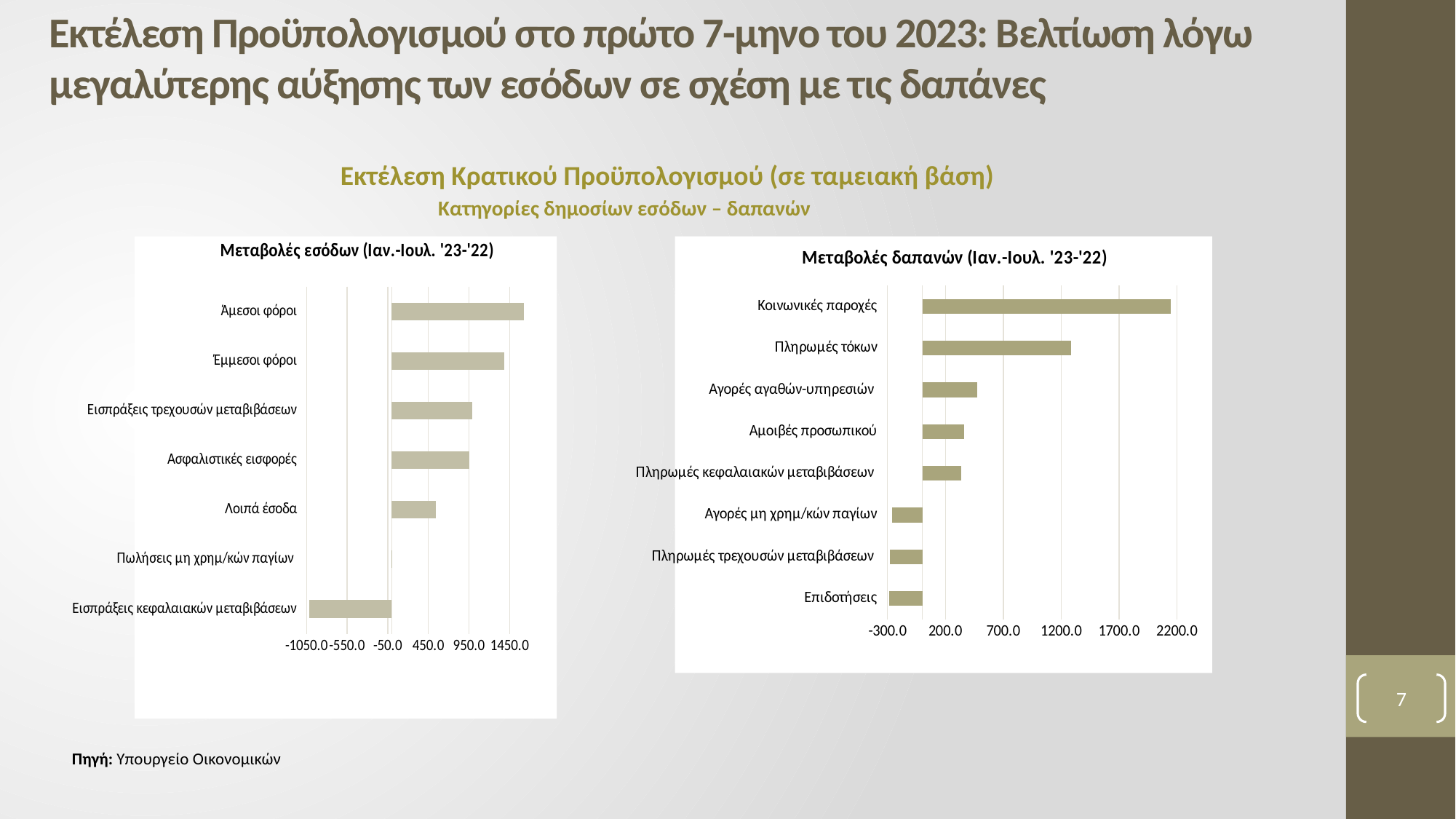
In the right chart 'Μεταβολές δαπανών', which is larger: Πληρωμές τόκων or Αγορές αγαθών-υπηρεσιών? Πληρωμές τόκων In the left chart 'Μεταβολές εσόδων', which category has the highest value? Άμεσοι φόροι In the right chart 'Μεταβολές δαπανών', which category has the highest value? Κοινωνικές παροχές In the right chart 'Μεταβολές δαπανών', is the value for Επιδοτήσεις greater or less than 200? less How many categories are shown in the right chart 'Μεταβολές δαπανών (Ιαν.-Ιουλ. '23-'22)'? 8 In the left chart 'Μεταβολές εσόδων', is the value for Άμεσοι φόροι greater or less than 1450? greater In the left chart 'Μεταβολές εσόδων', which category has the lowest value? Εισπράξεις κεφαλαιακών μεταβιβάσεων In the right chart 'Μεταβολές δαπανών', is the value for Κοινωνικές παροχές greater or less than 1700? greater What is the title of the right chart on the slide? Μεταβολές δαπανών (Ιαν.-Ιουλ. '23-'22) What kind of chart is the left chart titled 'Μεταβολές εσόδων (Ιαν.-Ιουλ. '23-'22)'? bar chart How many categories are shown in the left chart 'Μεταβολές εσόδων (Ιαν.-Ιουλ. '23-'22)'? 7